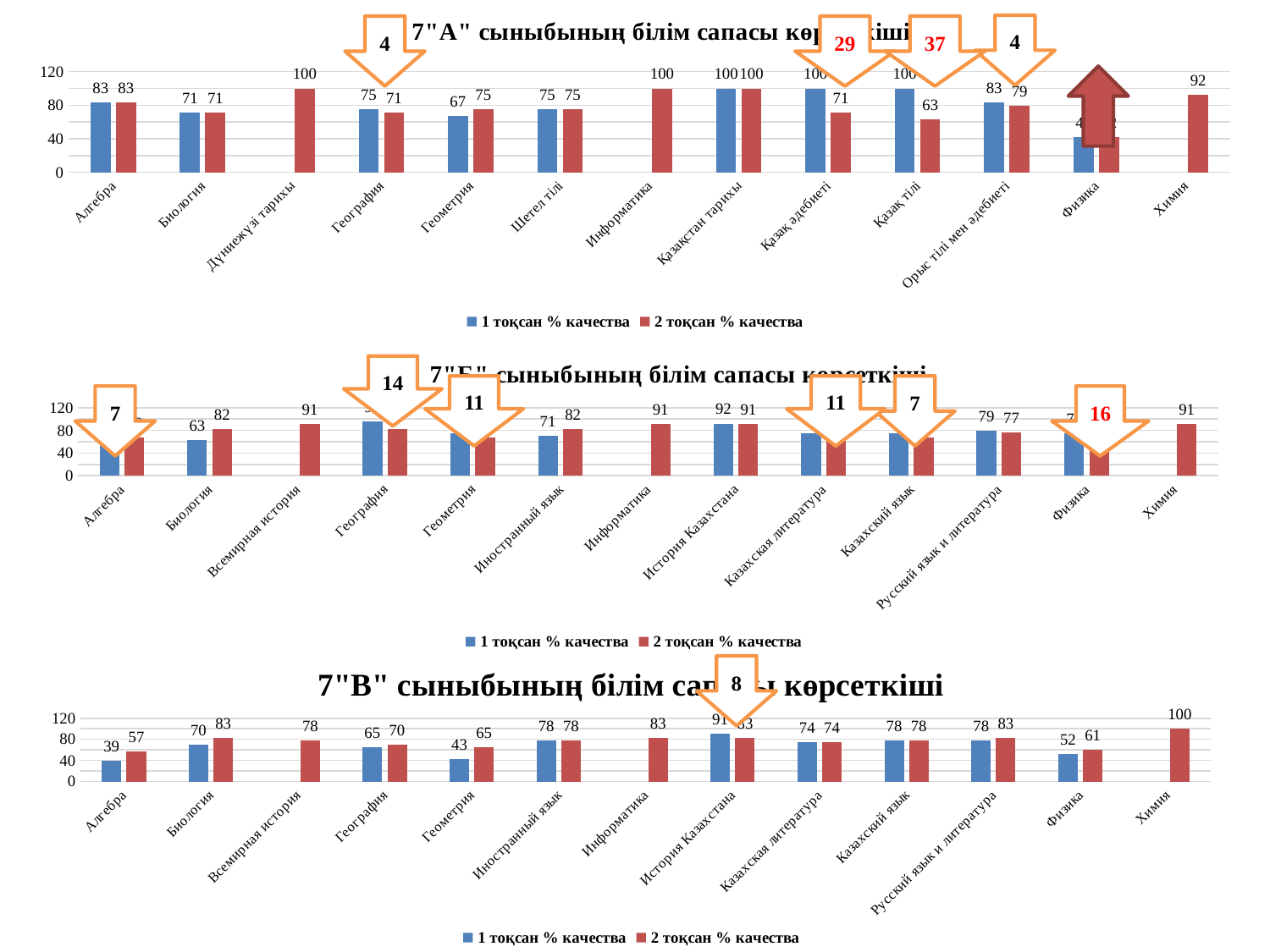
In the middle chart (7"Б" class), what is the 2 тоқсан % качества value for Биология? 82 In the bottom chart (7"В" class), which category has the highest 2 тоқсан % качества value? Химия In the bottom chart (7"В" class), which category has the lowest 1 тоқсан % качества value? Алгебра In the top chart (7"А" class), what is the difference between the 1 тоқсан and 2 тоқсан values for Қазақ әдебиеті? 29 What type of chart is the bottom chart (7"В" class)? Bar chart In the middle chart (7"Б" class), what is the 1 тоқсан % качества value for История Казахстана? 92 In the bottom chart (7"В" class), what is the 1 тоқсан % качества value for Алгебра? 39 In the top chart (7"А" class), what is the value of the 1 тоқсан % качества series for Геометрия? 67 How many series does the legend of the top chart (7"А" class) list? 2 In the top chart (7"А" class), what is the value of the 2 тоқсан % качества series for Қазақ тілі? 63 In the bottom chart (7"В" class), what is the difference between the 2 тоқсан and 1 тоқсан values for Геометрия? 22 In the top chart (7"А" class), which is larger for Орыс тілі мен әдебиеті: the 1 тоқсан value or the 2 тоқсан value? 1 тоқсан % качества